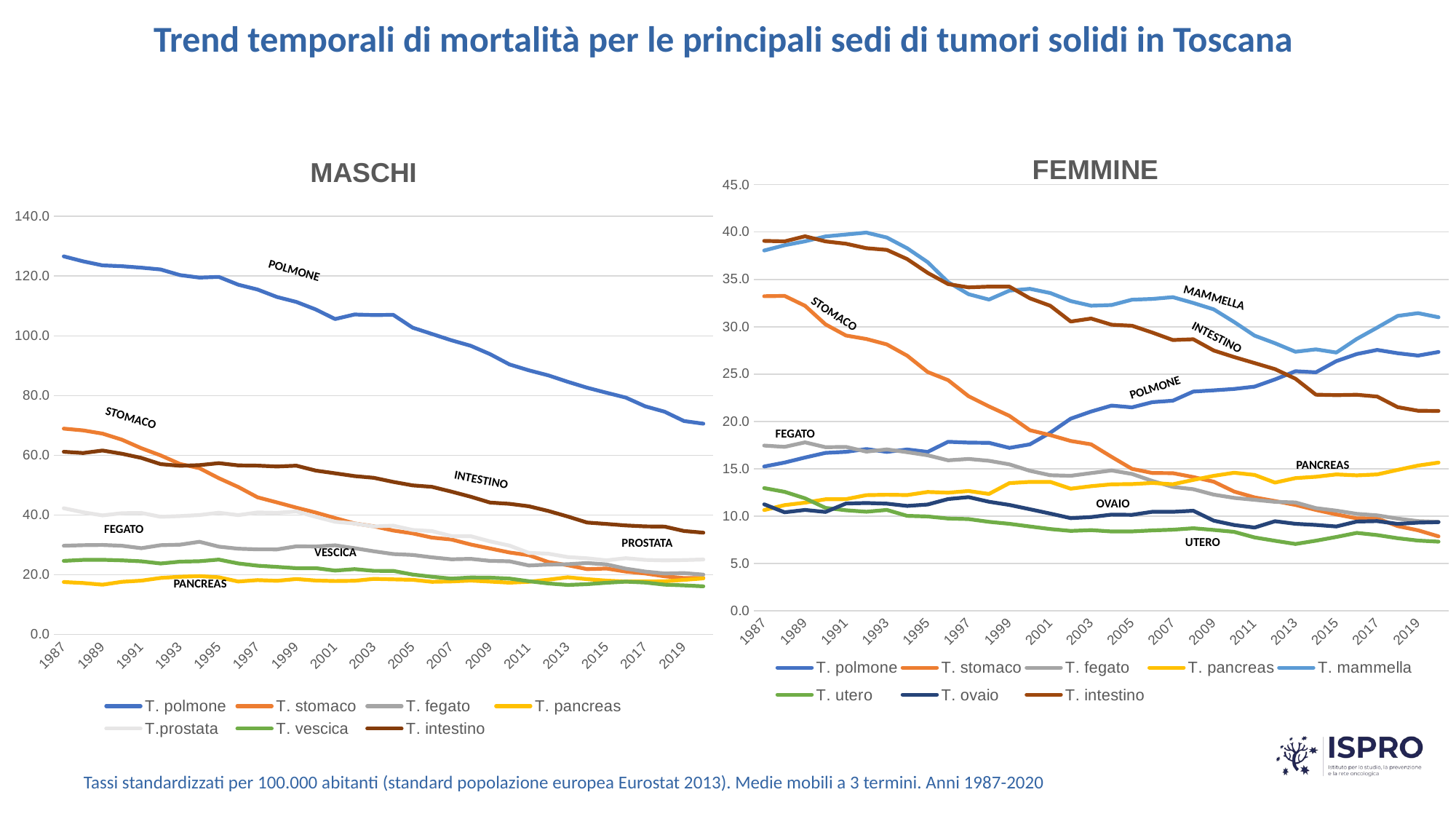
In the FEMMINE chart, is the value for T. stomaco in 2019 greater or less than 10? less In the FEMMINE chart, which series has the highest value in 2019? T. mammella In the MASCHI chart, which series has the highest value in 1987? T. polmone In the FEMMINE chart, does the T. polmone line rise or fall from 1987 to 2019? rise What is the title of the slide? Trend temporali di mortalità per le principali sedi di tumori solidi in Toscana What kind of chart is the MASCHI chart? line chart How many series does the legend of the FEMMINE chart list? 8 In the MASCHI chart, does the T. polmone line rise or fall from 1987 to 2019? fall In the MASCHI chart, is the value for T. polmone in 1987 greater or less than 120? greater In the FEMMINE chart, does the T. stomaco line rise or fall over the period shown? fall How many series does the legend of the MASCHI chart list? 7 In the MASCHI chart, which is larger in 2019: T. intestino or T. stomaco? T. intestino